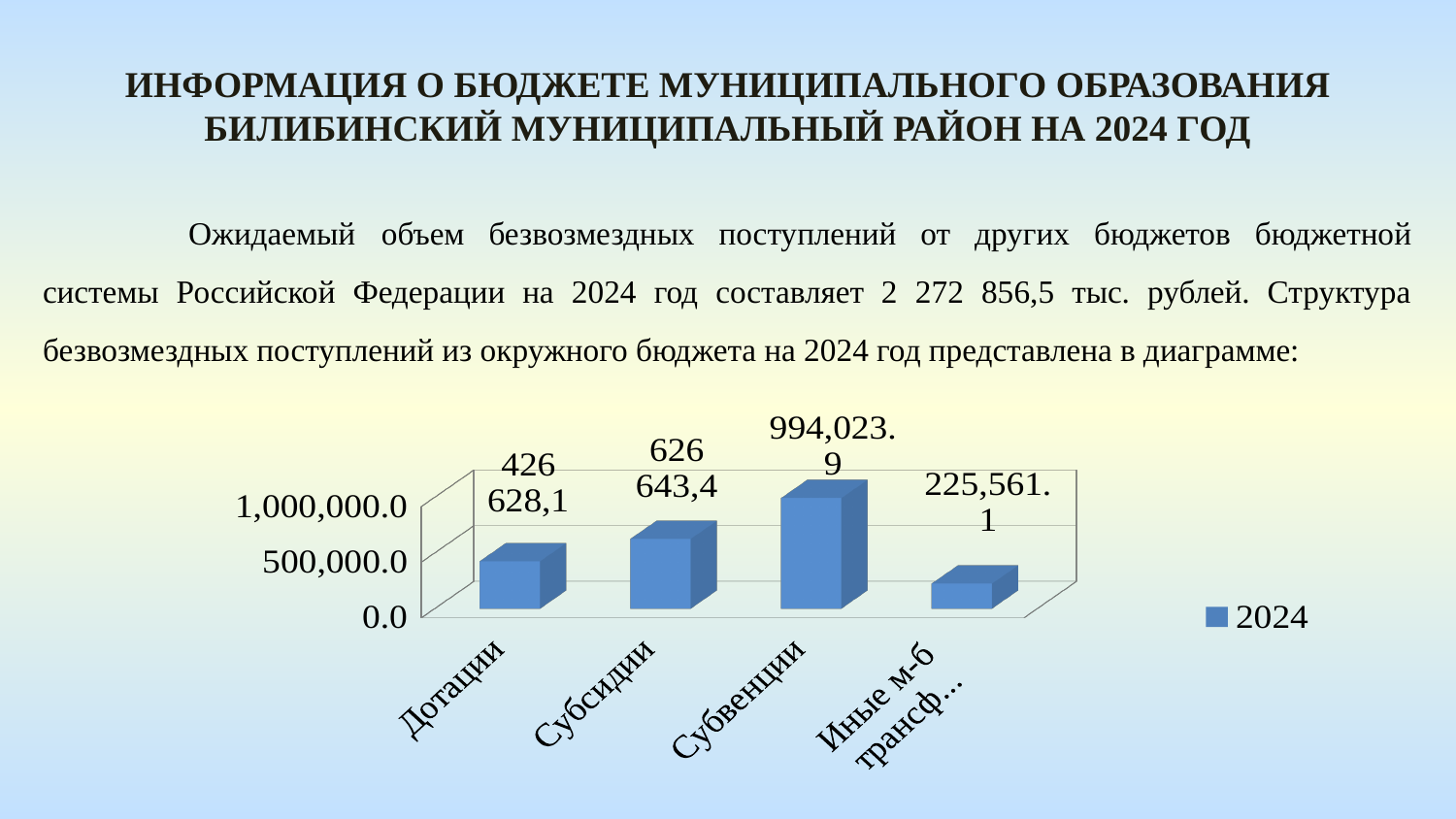
What is the value for Субсидии? 626 643,4 Which category has the highest value? Субвенции Is the value for Дотации greater or less than 500,000.0? less Which is larger, the value for Субсидии or the value for Дотации? Субсидии What is the difference between the value for Субвенции and the value for Иные м-б трансф...? 768,462.8 What entry does the legend list? 2024 Which category has the lowest value? Иные м-б трансф... What type of chart is shown on the slide? bar chart How many categories are shown on the x axis? 4 What is the value for Дотации? 426 628,1 What is the value for Субвенции? 994,023.9 What is the value for the category labelled Иные м-б трансф...? 225,561.1